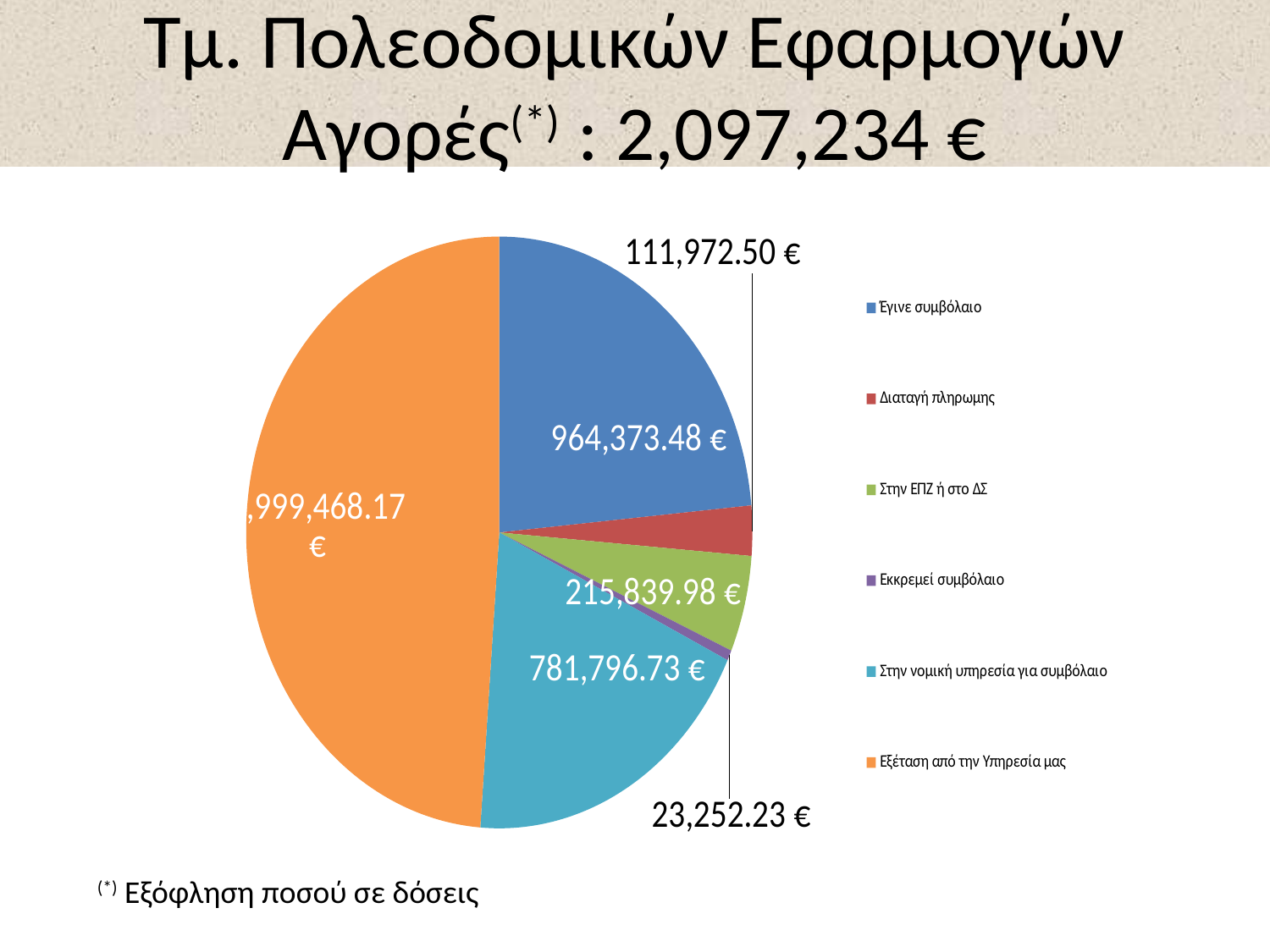
What is the value for Εκκρεμεί συμβόλαιο? 23,252.23 € What is the value for Στην ΕΠΖ ή στο ΔΣ? 215,839.98 € Which category has the largest slice of the pie? Εξέταση από την Υπηρεσία μας How many slices does the pie chart have? 6 What is the difference between the values for Στην ΕΠΖ ή στο ΔΣ and Διαταγή πληρωμης? 103,867.48 € What is the value for Διαταγή πληρωμης? 111,972.50 € Which is larger, the value for Έγινε συμβόλαιο or the value for Στην νομική υπηρεσία για συμβόλαιο? Έγινε συμβόλαιο What kind of chart is shown on the slide? pie chart What is the value for Στην νομική υπηρεσία για συμβόλαιο? 781,796.73 € What is the value for Έγινε συμβόλαιο? 964,373.48 € Which category has the smallest slice of the pie? Εκκρεμεί συμβόλαιο What is the difference between the values for Έγινε συμβόλαιο and Στην νομική υπηρεσία για συμβόλαιο? 182,576.75 €